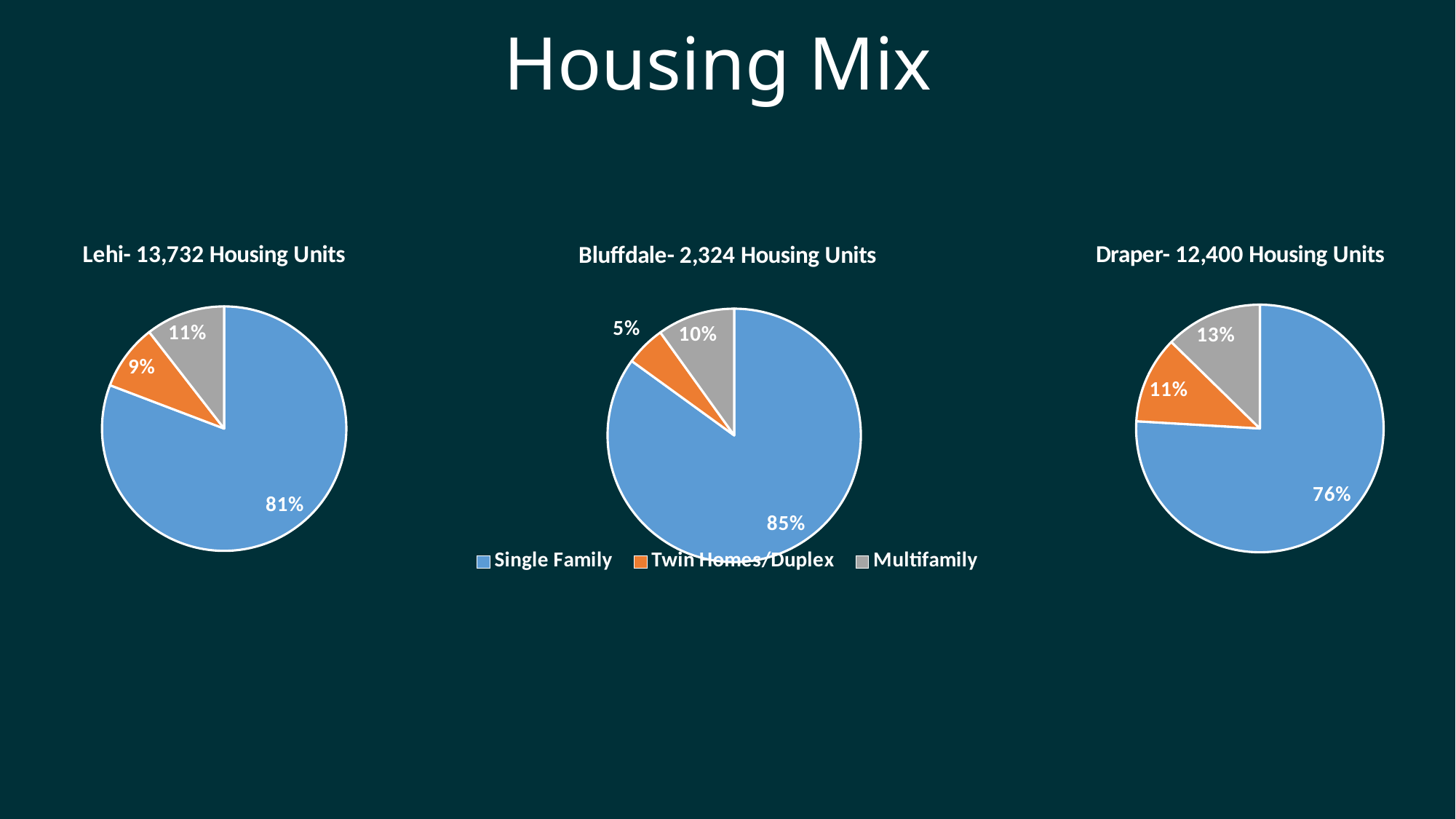
Which city's pie chart shows a larger Single Family share, Bluffdale or Draper? Bluffdale In the Draper pie chart, which category has the largest share? Single Family What type of chart is used for the Lehi housing mix? pie chart How many categories does the shared legend list? 3 In the Draper pie chart, what is the difference between the Single Family share and the Multifamily share? 63% In the Lehi pie chart, what share of housing units is Twin Homes/Duplex? 9% In the Bluffdale pie chart, which category has the smallest share? Twin Homes/Duplex In the Bluffdale pie chart, what share of housing units is Twin Homes/Duplex? 5% In the Lehi pie chart, is the Multifamily share larger or smaller than the Twin Homes/Duplex share? larger How many slices does the Bluffdale pie chart have? 3 In the Lehi pie chart, what share of housing units is Single Family? 81% In the Draper pie chart, what share of housing units is Multifamily? 13%